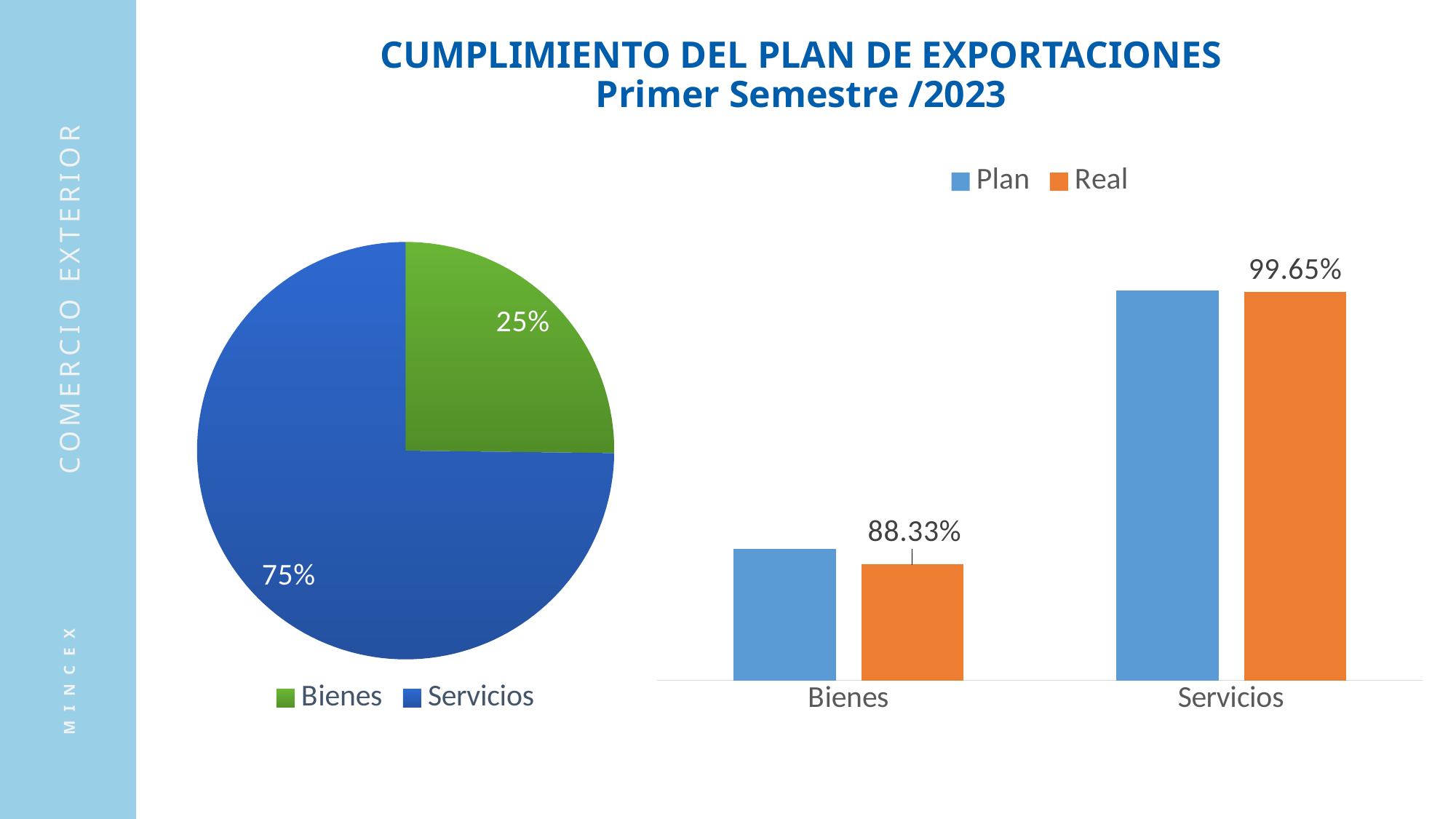
What kind of chart is the chart on the left of the slide? pie chart In the pie chart on the left, what share does Servicios have? 75% What kind of chart is the chart on the right of the slide? bar chart In the bar chart on the right, which category has the higher Real value, Bienes or Servicios? Servicios In the pie chart on the left, what share does Bienes have? 25% In the pie chart on the left, which slice is the largest? Servicios In the bar chart on the right, what is the Real value for Servicios? 99.65% In the pie chart on the left, how many slices are there? 2 In the bar chart on the right, what is the Real value for Bienes? 88.33% In the bar chart on the right, which colour represents the Real series? orange In the bar chart on the right, how many series does the legend list? 2 In the pie chart on the left, which slice is the smallest? Bienes